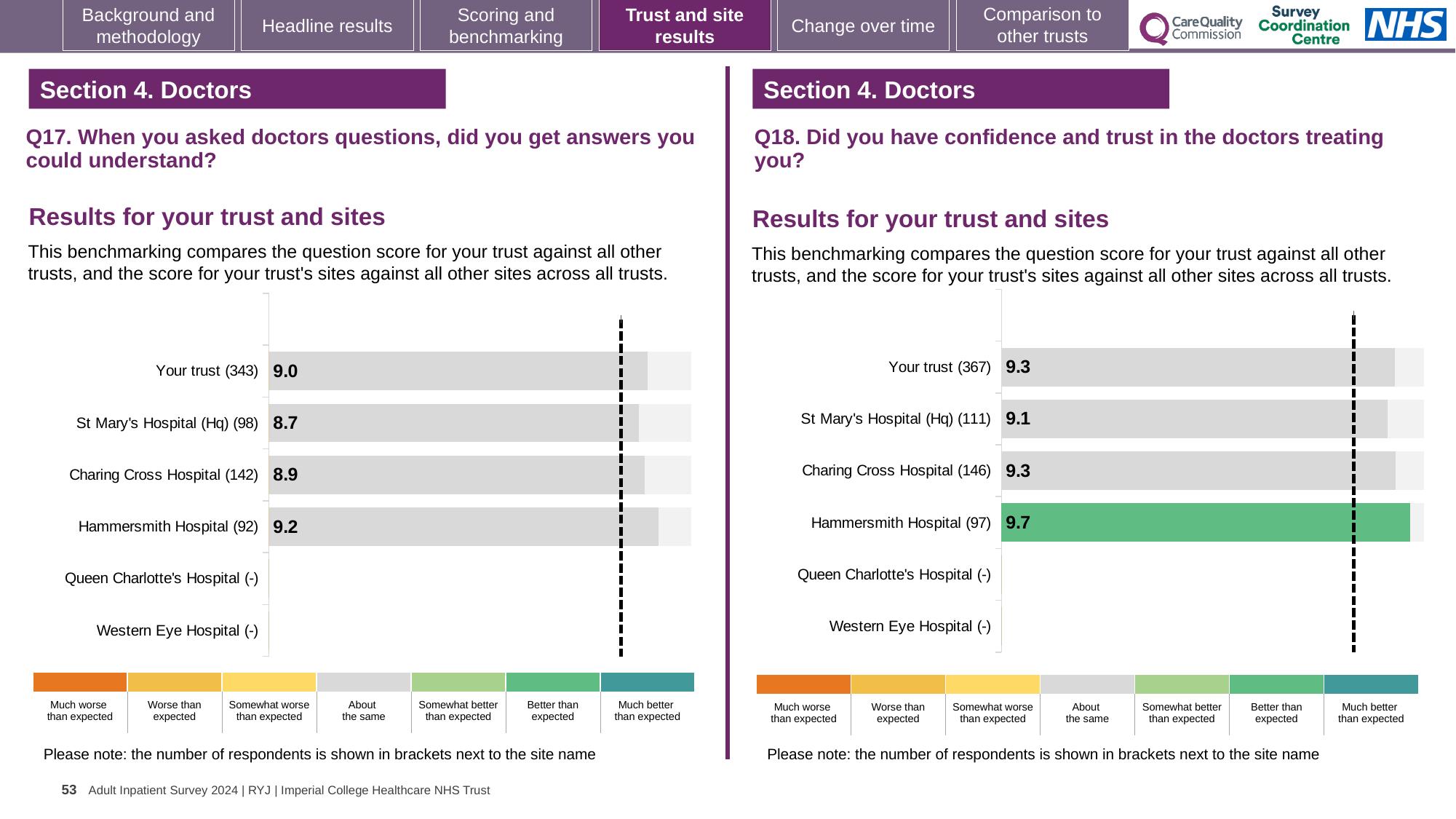
In the Q17 chart on the left, what is the score for Your trust (343)? 9.0 In the Q18 chart on the right, what is the score for Hammersmith Hospital (97)? 9.7 In the Q17 chart on the left, which site has the highest score? Hammersmith Hospital (92) In the Q18 chart on the right, what is the difference between the scores for Hammersmith Hospital (97) and Your trust (367)? 0.4 In the Q18 chart on the right, which site has the highest score? Hammersmith Hospital (97) In the Q17 chart on the left, which site has the lowest score? St Mary's Hospital (Hq) (98) In the Q18 chart on the right, what is the score for St Mary's Hospital (Hq) (111)? 9.1 How many site rows (including Your trust) are listed on the Q17 chart on the left? 6 In the Q17 chart on the left, what is the score for St Mary's Hospital (Hq) (98)? 8.7 What kind of chart is used for the Q18 results on the right? Bar chart In the Q17 chart on the left, what is the difference between the scores for Hammersmith Hospital (92) and Charing Cross Hospital (142)? 0.3 In the Q18 chart on the right, which is larger: the score for Your trust (367) or St Mary's Hospital (Hq) (111)? Your trust (367)